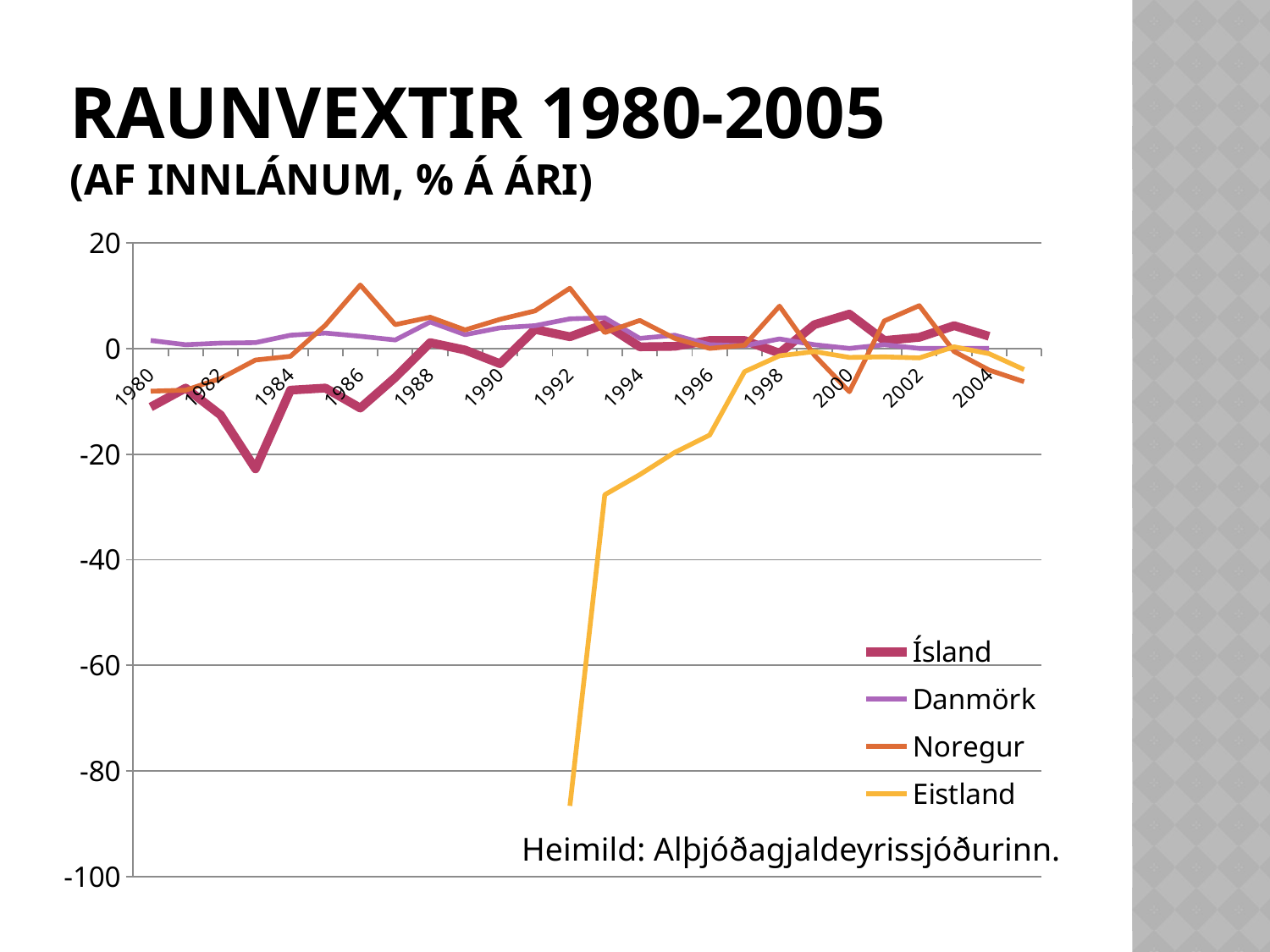
Does the Eistland series rise or fall from 1992 to 1998? Rise Which is larger in 1986, the value for Noregur or the value for Ísland? Noregur Which series are listed in the legend? Ísland, Danmörk, Noregur, Eistland Is the value for Noregur in 1986 greater or less than 0? greater In which year does the Ísland series reach its lowest value? 1983 Which series reaches the lowest value on the chart? Eistland How many series does the legend list? 4 What kind of chart is shown on the slide? Line chart Is the value for Ísland in 1983 greater or less than -20? less What is the title of the chart? Raunvextir 1980-2005 (af innlánum, % á ári) Is the value for Eistland in 1992 greater or less than -80? less